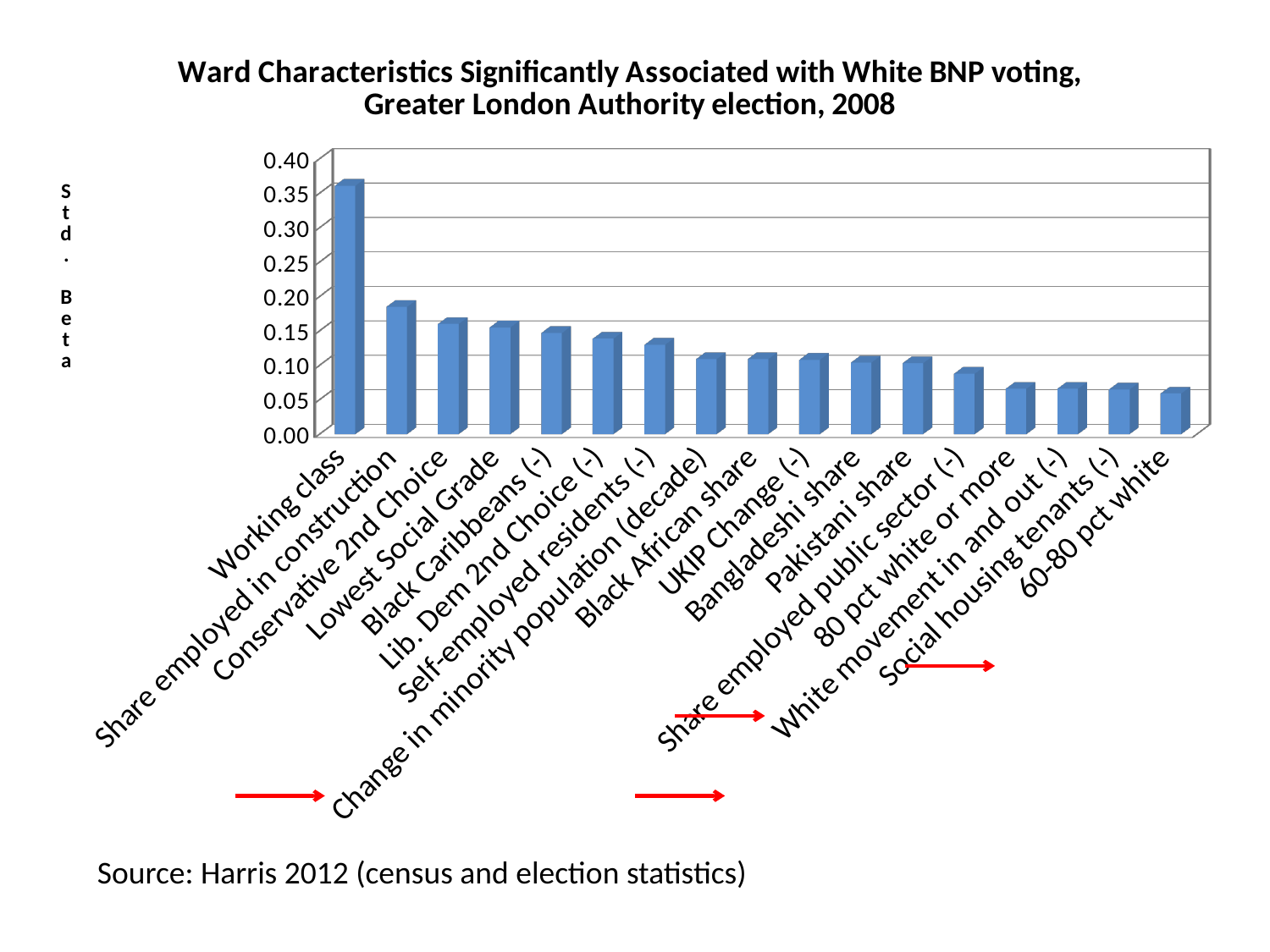
Is the value for Share employed in construction greater or less than 0.20? less What is the label on the vertical axis of the chart? Std. Beta Is the value for 60-80 pct white greater or less than 0.10? less Which has the larger value, Conservative 2nd Choice or Social housing tenants (-)? Conservative 2nd Choice What kind of chart is shown on the slide? Bar chart Is the value for Black Caribbeans (-) greater or less than 0.10? greater Do the bar values rise or fall moving from left to right along the x axis? Fall Which ward characteristic has the highest standardised beta? Working class How many ward characteristics (bars) are plotted in the chart? 17 Which has the larger value, Working class or Share employed in construction? Working class